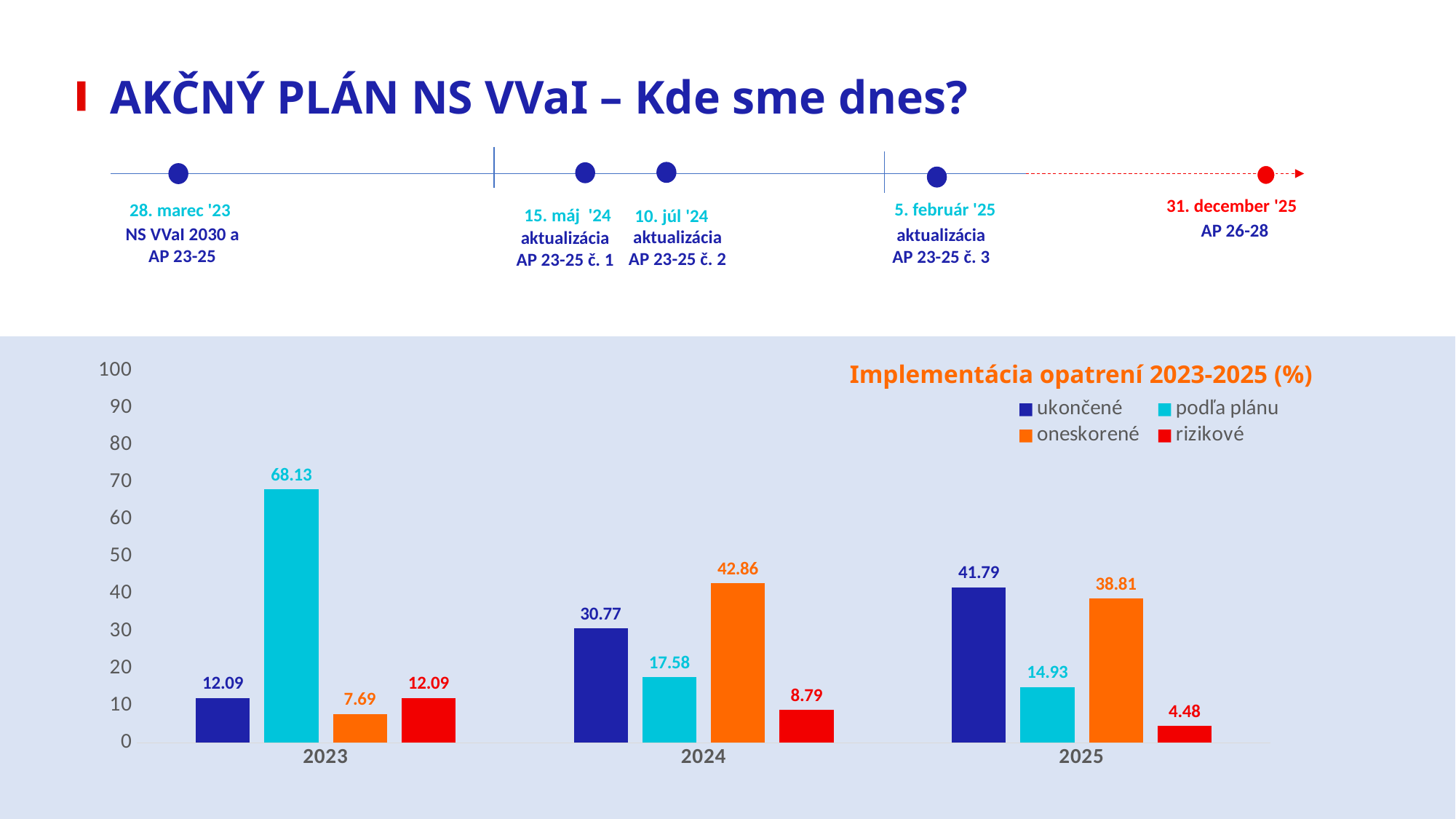
What is the value for "ukončené" in 2025? 41.79 How many series does the legend list? 4 Does the "podľa plánu" value rise or fall from 2023 to 2025? fall How many years are shown on the x axis? 3 What is the difference between the "oneskorené" values for 2024 and 2025? 4.05 In which year is the "ukončené" value highest? 2025 What is the value for "rizikové" in 2025? 4.48 In which year is the "rizikové" value lowest? 2025 What is the value for "oneskorené" in 2024? 42.86 What is the value for "podľa plánu" in 2023? 68.13 What kind of chart is shown on the slide? bar chart Which is larger in 2025: "ukončené" or "oneskorené"? ukončené